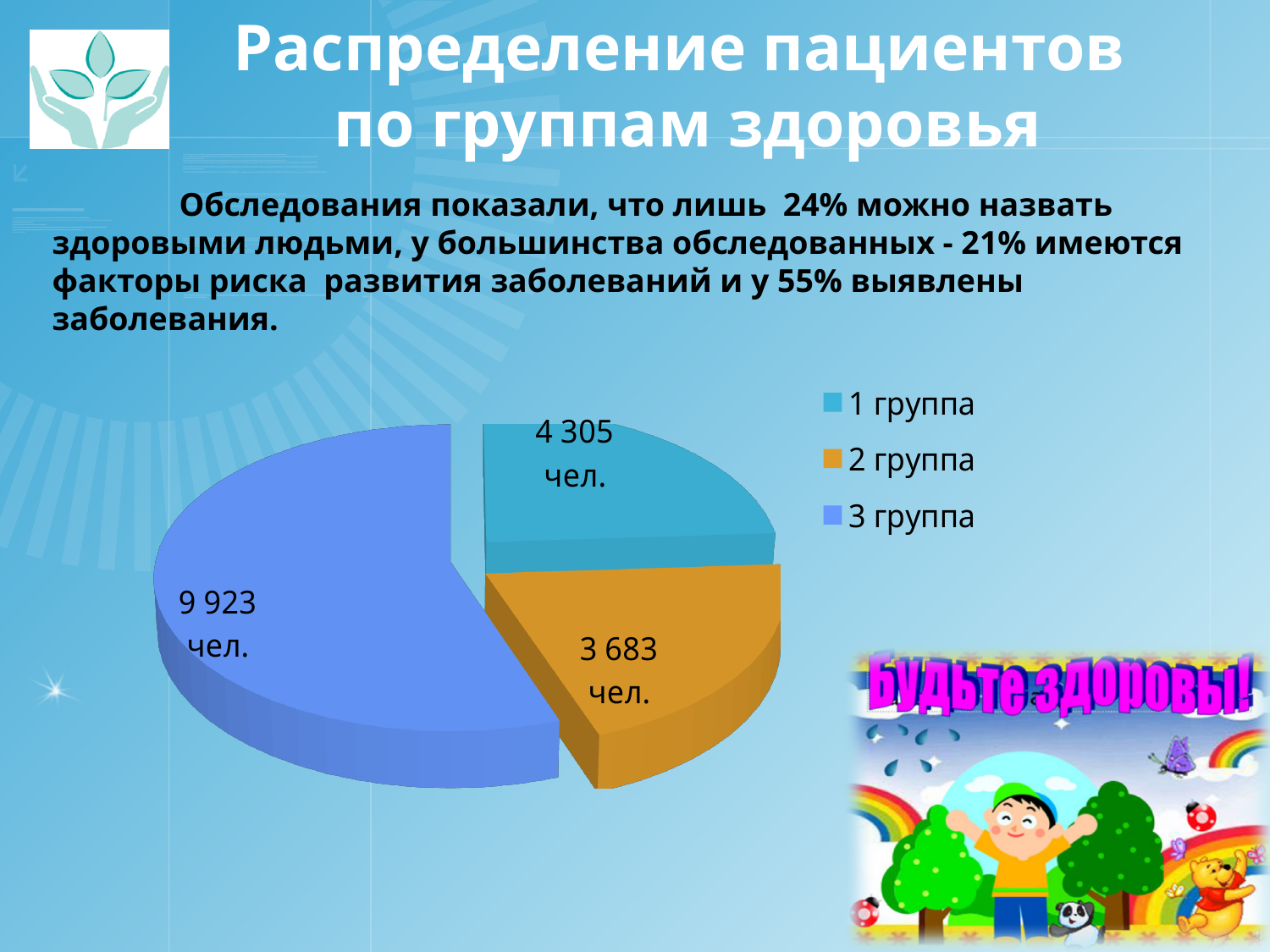
What is the value shown for 1 группа in the pie chart? 4 305 чел. How many slices does the pie chart have? 3 Which group has the smallest slice in the pie chart? 2 группа What colour is the slice for 3 группа in the pie chart? blue Which is larger, the value for 1 группа or the value for 2 группа? 1 группа What is the difference between the values for 1 группа and 2 группа? 622 чел. What is the value shown for 2 группа in the pie chart? 3 683 чел. What is the difference between the values for 3 группа and 1 группа? 5 618 чел. What kind of chart is shown on the slide? pie chart How many entries does the legend of the pie chart list? 3 Which group has the largest slice in the pie chart? 3 группа What is the value shown for 3 группа in the pie chart? 9 923 чел.